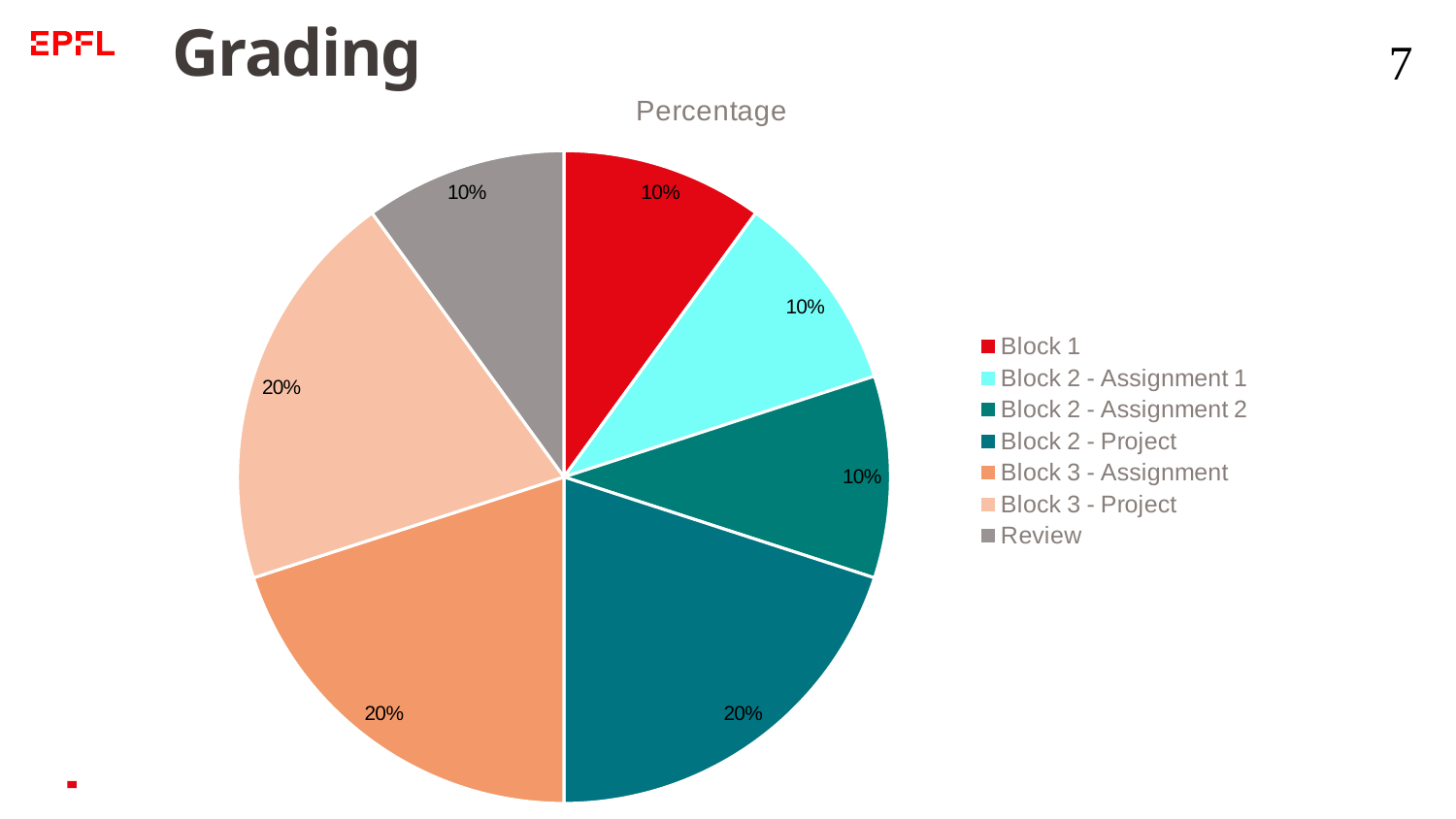
What is the value shown for Block 2 - Assignment 1? 10% What is the value shown for Review? 10% Which colour is used for the Block 1 slice? red What is the difference between the value for Block 2 - Project and the value for Block 2 - Assignment 2? 10% What is the title of the chart? Percentage What share of the pie does Block 1 represent? 10% What is the value shown for Block 3 - Assignment? 20% What is the value shown for Block 2 - Project? 20% How many slices does the pie chart have? 7 Which is larger, the slice for Block 3 - Project or the slice for Review? Block 3 - Project What kind of chart is shown on the slide? pie chart How many entries does the legend list? 7